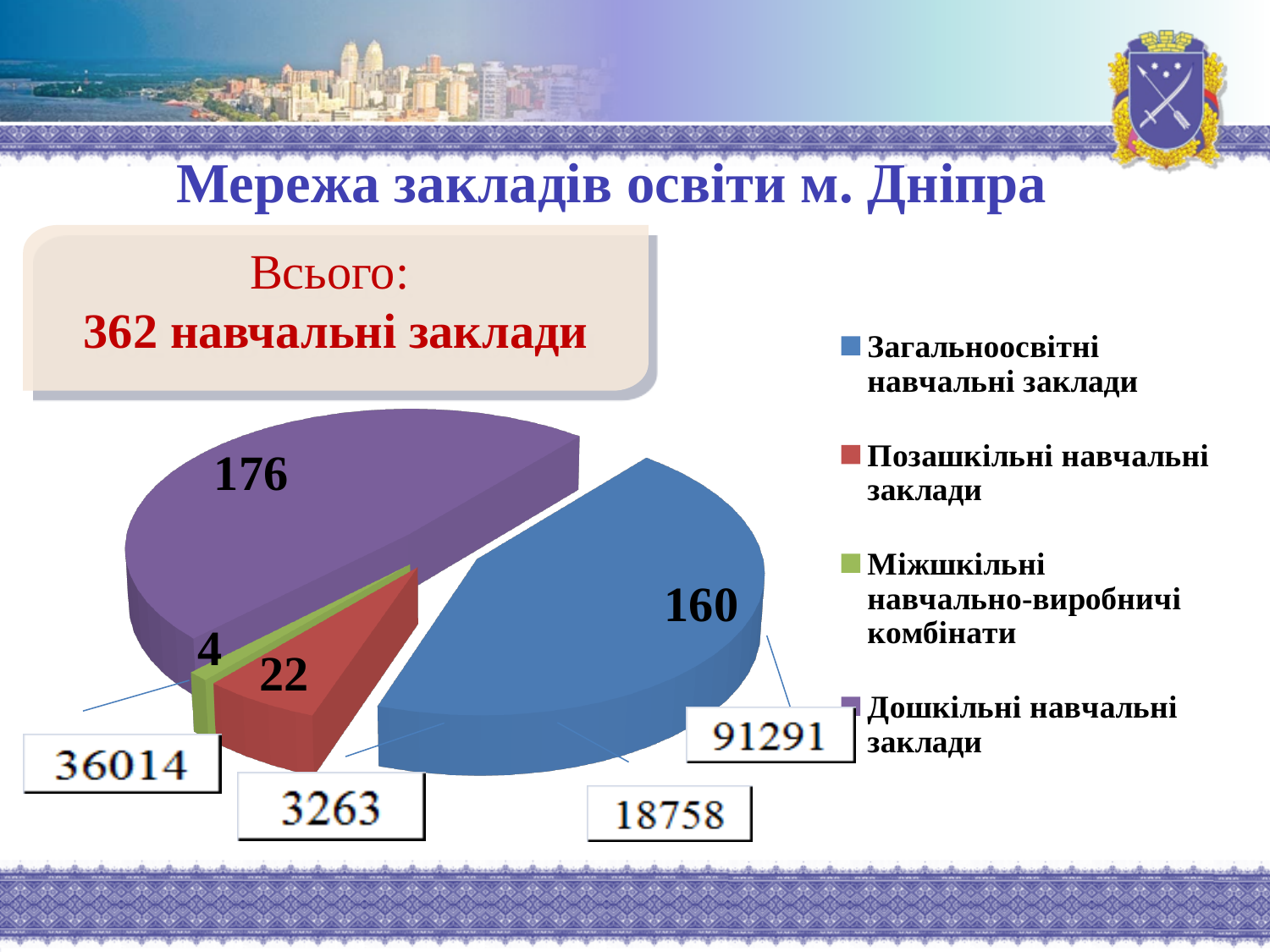
Which is larger: Позашкільні навчальні заклади or Міжшкільні навчально-виробничі комбінати? Позашкільні навчальні заклади What is the value for Загальноосвітні навчальні заклади? 160 What is the value for Дошкільні навчальні заклади? 176 What is the difference between the values for Дошкільні навчальні заклади and Загальноосвітні навчальні заклади? 16 What type of chart is shown on the slide? pie chart What is the value for Міжшкільні навчально-виробничі комбінати? 4 Which category has the largest slice? Дошкільні навчальні заклади How many entries does the legend list? 4 How many slices does the pie chart have? 4 What is the value for Позашкільні навчальні заклади? 22 What total number of educational institutions is stated on the slide? 362 Which category has the smallest slice? Міжшкільні навчально-виробничі комбінати